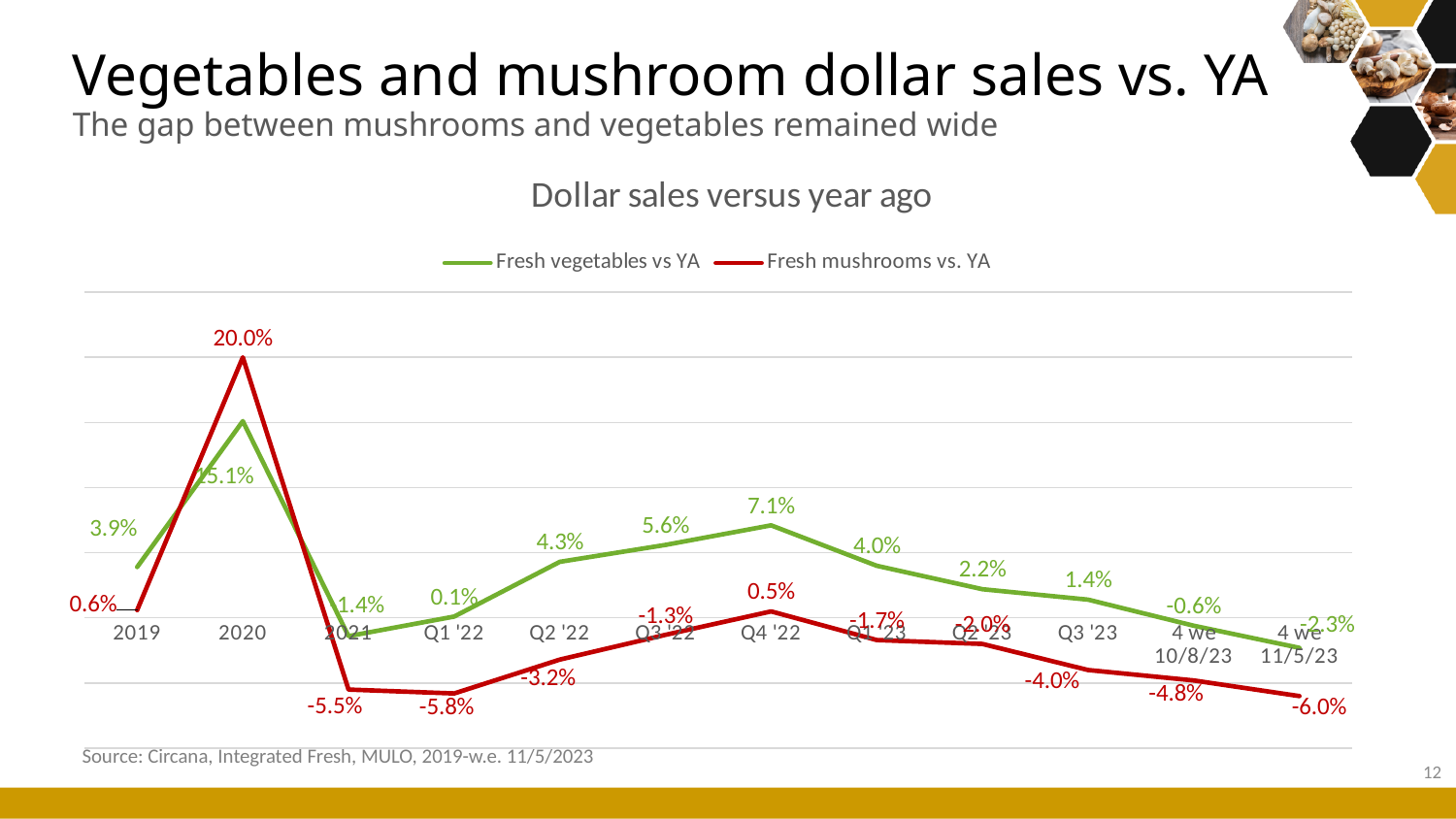
What is the value for Fresh mushrooms vs. YA in 2020? 20.0% In which period is Fresh mushrooms vs. YA highest? 2020 What kind of chart is shown on the slide? Line chart How many time periods are plotted along the x axis? 12 What is the value for Fresh mushrooms vs. YA in Q1 '22? -5.8% What is the value for Fresh vegetables vs YA in Q4 '22? 7.1% In which period is Fresh mushrooms vs. YA lowest? 4 we 11/5/23 What is the difference between Fresh vegetables vs YA and Fresh mushrooms vs. YA in Q4 '22? 6.6 percentage points In which period is Fresh vegetables vs YA highest? 2020 Does Fresh vegetables vs YA rise or fall from Q4 '22 to 4 we 11/5/23? Fall In Q1 '22, which series has the larger value, Fresh vegetables vs YA or Fresh mushrooms vs. YA? Fresh vegetables vs YA How many series does the legend list? 2